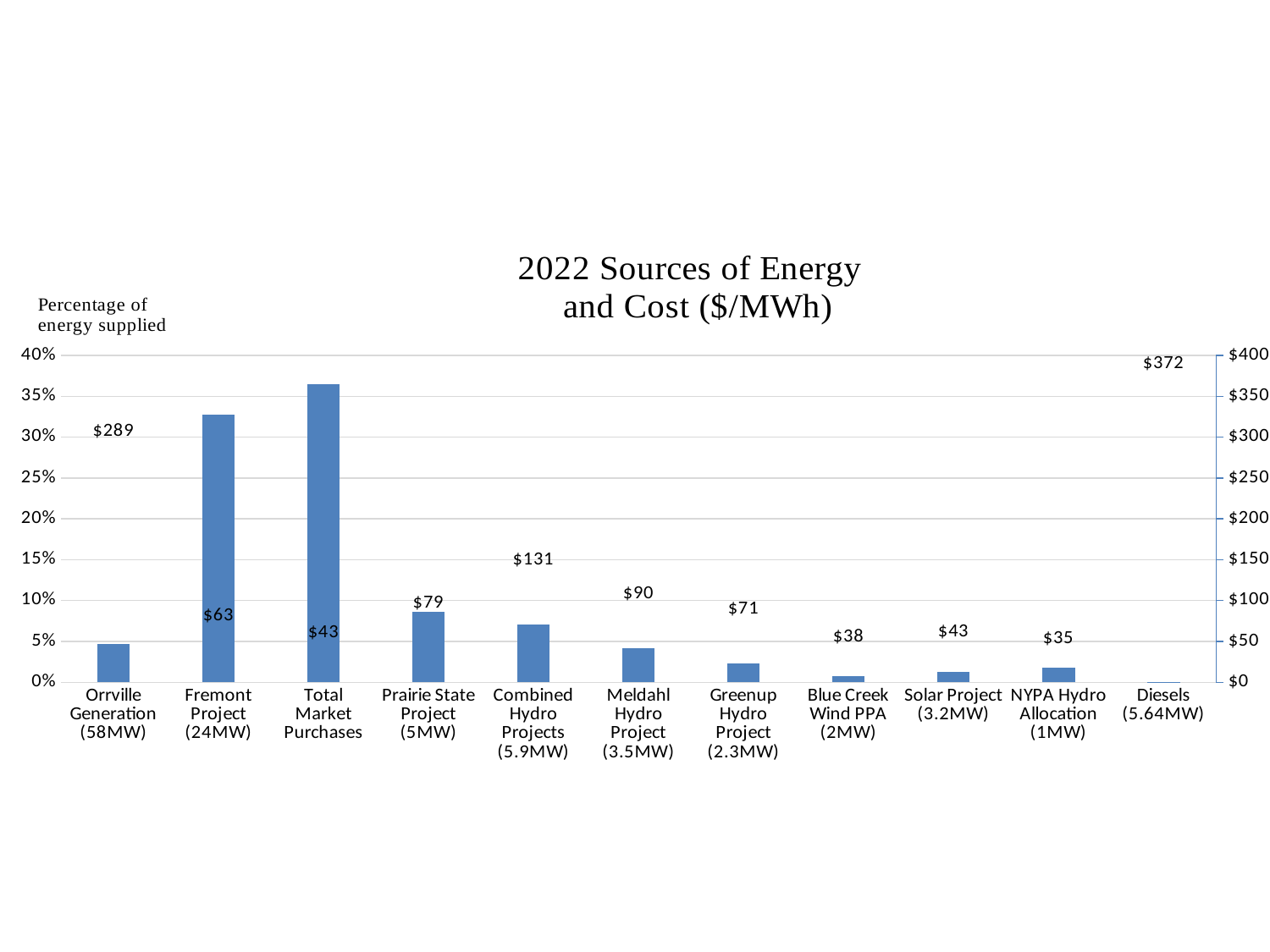
What is the cost label shown for Combined Hydro Projects (5.9MW)? $131 Which source has the tallest bar for percentage of energy supplied? Total Market Purchases What is the difference between the cost labels for Orrville Generation and Fremont Project? $226 Which has the larger cost label, Prairie State Project or Greenup Hydro Project? Prairie State Project Is the percentage of energy supplied by Total Market Purchases greater or less than 30%? greater What is the cost label shown for Orrville Generation (58MW)? $289 What is the cost label shown for Total Market Purchases? $43 How many energy sources are shown on the x axis? 11 What is the title of the chart? 2022 Sources of Energy and Cost ($/MWh) Which source has the highest cost label ($/MWh)? Diesels (5.64MW) Which source has the lowest cost label ($/MWh)? NYPA Hydro Allocation (1MW) Is the percentage of energy supplied by Prairie State Project greater or less than 10%? less